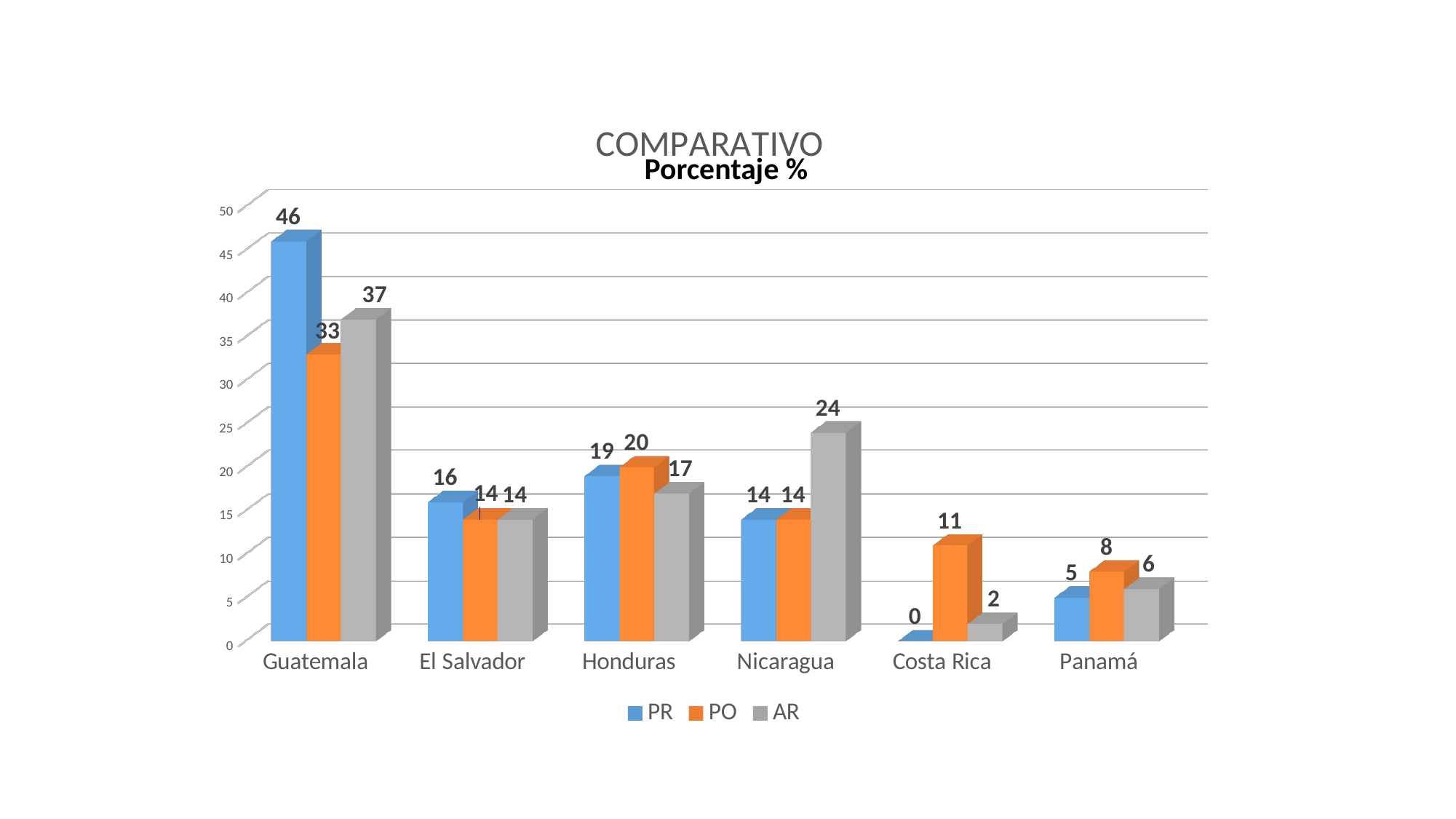
Which country has the lowest PR value? Costa Rica How many countries are shown on the x axis? 6 What is the PR value for Guatemala? 46 What is the AR value for Nicaragua? 24 What is the difference between the PR and PO values for Guatemala? 13 How many series does the legend list? 3 What kind of chart is shown on the slide? Bar chart Which series is shown in orange? PO Which is larger for Honduras, the PO value or the AR value? PO What is the title of the chart? COMPARATIVO Which country has the highest PR value? Guatemala What is the PO value for Costa Rica? 11